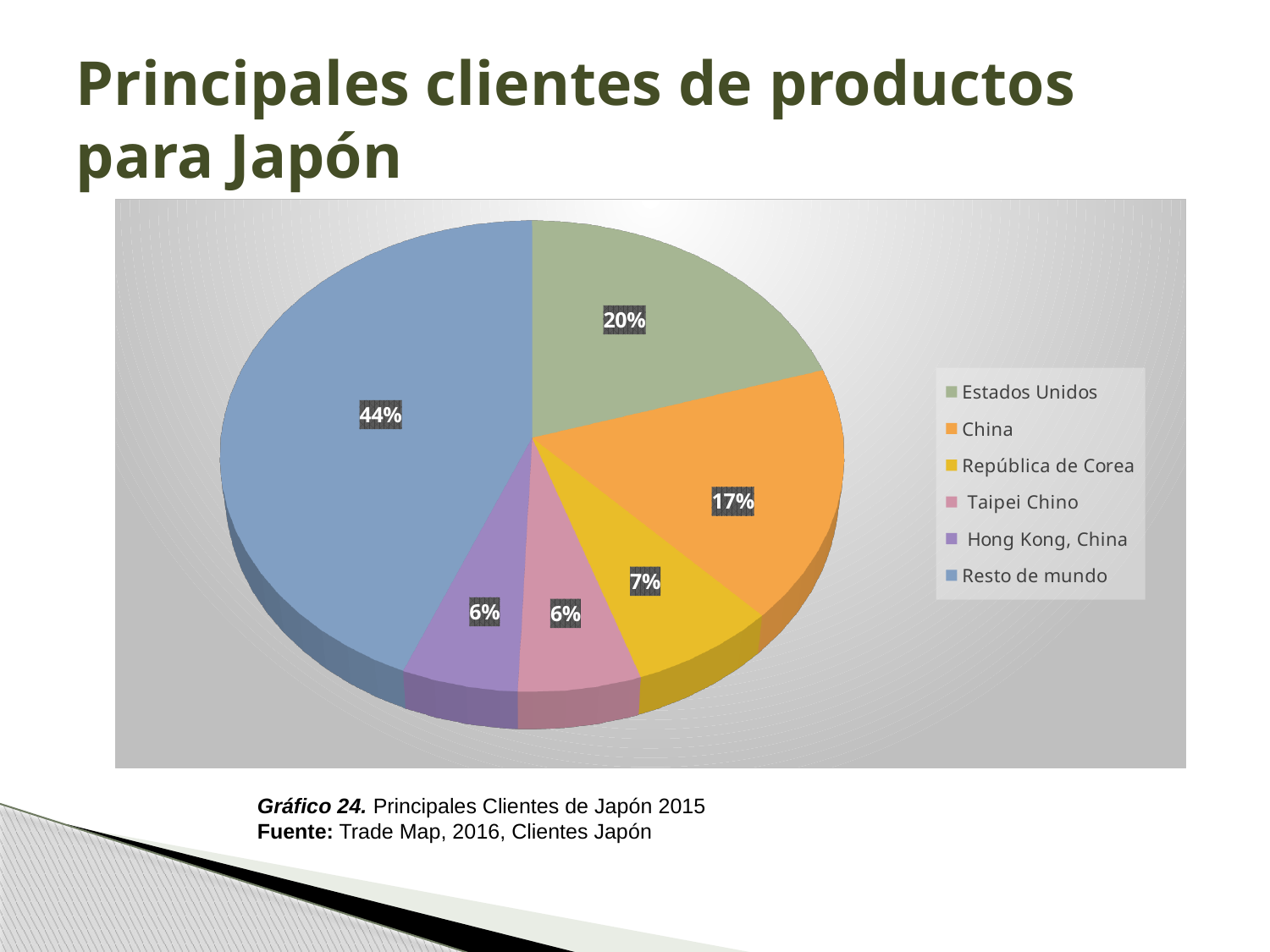
What share of the pie does China hold? 17% Which is larger, the share for China or the share for República de Corea? China How many slices does the pie chart have? 6 What is the difference between the shares of Estados Unidos and China? 3% What is the difference between the shares of Resto de mundo and Estados Unidos? 24% Which legend entry is shown in orange? China What share of the pie does República de Corea hold? 7% How many entries does the legend list? 6 What share of the pie does Estados Unidos hold? 20% What kind of chart is shown on the slide? pie chart Which category has the largest slice of the pie? Resto de mundo